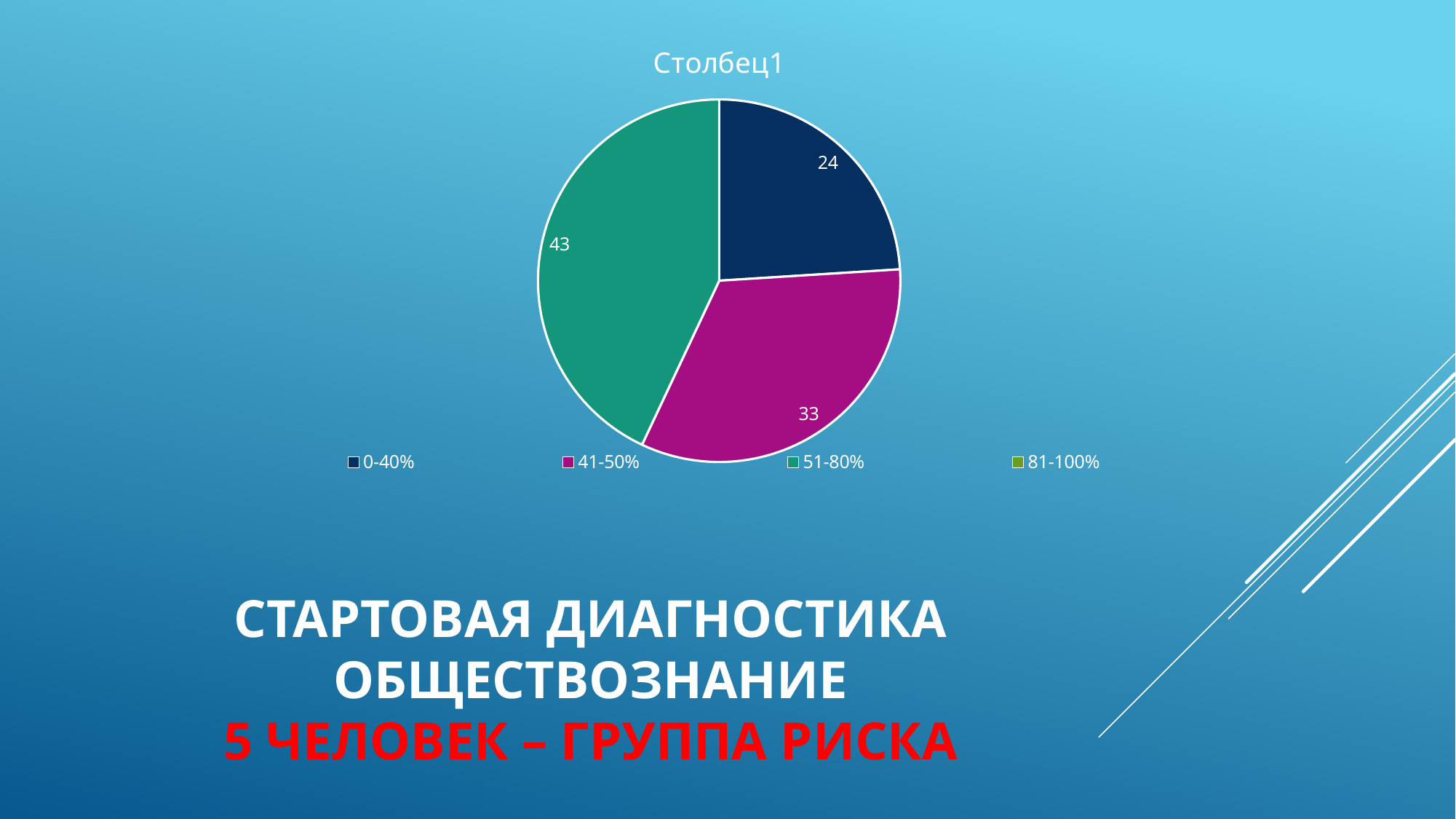
How many slices are visible in the pie? 3 What is the value for the 41-50% category? 33 What is the title of the chart? Столбец1 How many entries does the legend list? 4 Which labelled slice of the pie is the smallest? 0-40% What kind of chart is shown on the slide? pie chart What is the value for the 51-80% category? 43 What is the difference between the values for 51-80% and 0-40%? 19 Which is larger, the value for 41-50% or the value for 0-40%? 41-50% What is the value for the 0-40% category? 24 What share of the pie does the 51-80% slice represent? 43% Which category has the largest slice of the pie? 51-80%